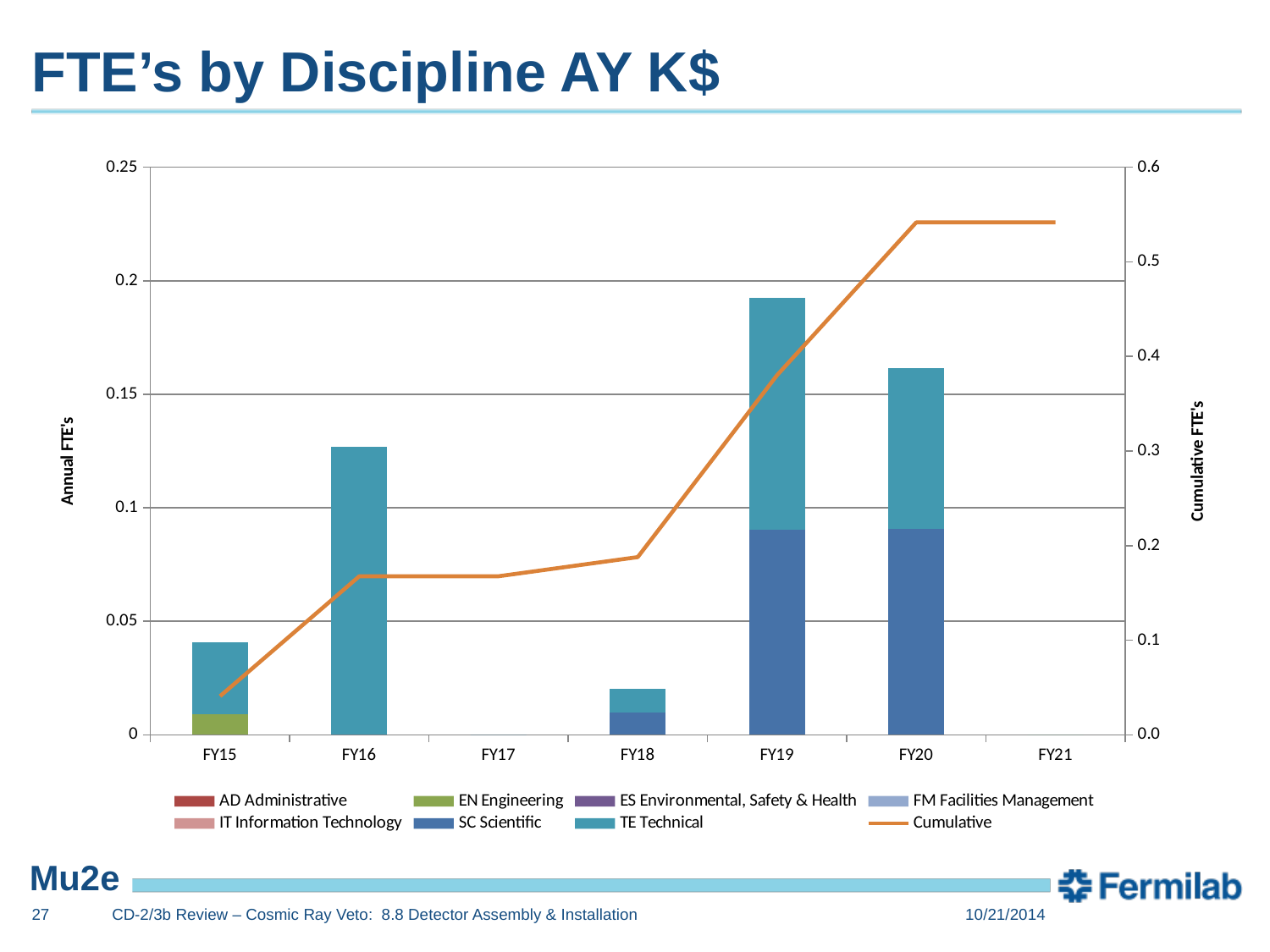
Is the Cumulative value at FY20 greater or less than 0.5 on the right axis? greater Is the total annual FTE value for FY16 greater or less than 0.1? greater What kind of chart is shown on the slide? A stacked bar chart combined with a line chart Which stacked bar is taller, FY15 or FY18? FY15 Is the total annual FTE value for FY18 greater or less than 0.05? less Which fiscal year has the tallest stacked bar? FY19 How many fiscal years are shown on the x axis? 7 What is the title of the left vertical axis? Annual FTE's How many entries does the legend list? 8 Does the Cumulative line rise or fall from FY15 to FY20? rise Which stacked bar is taller, FY16 or FY20? FY20